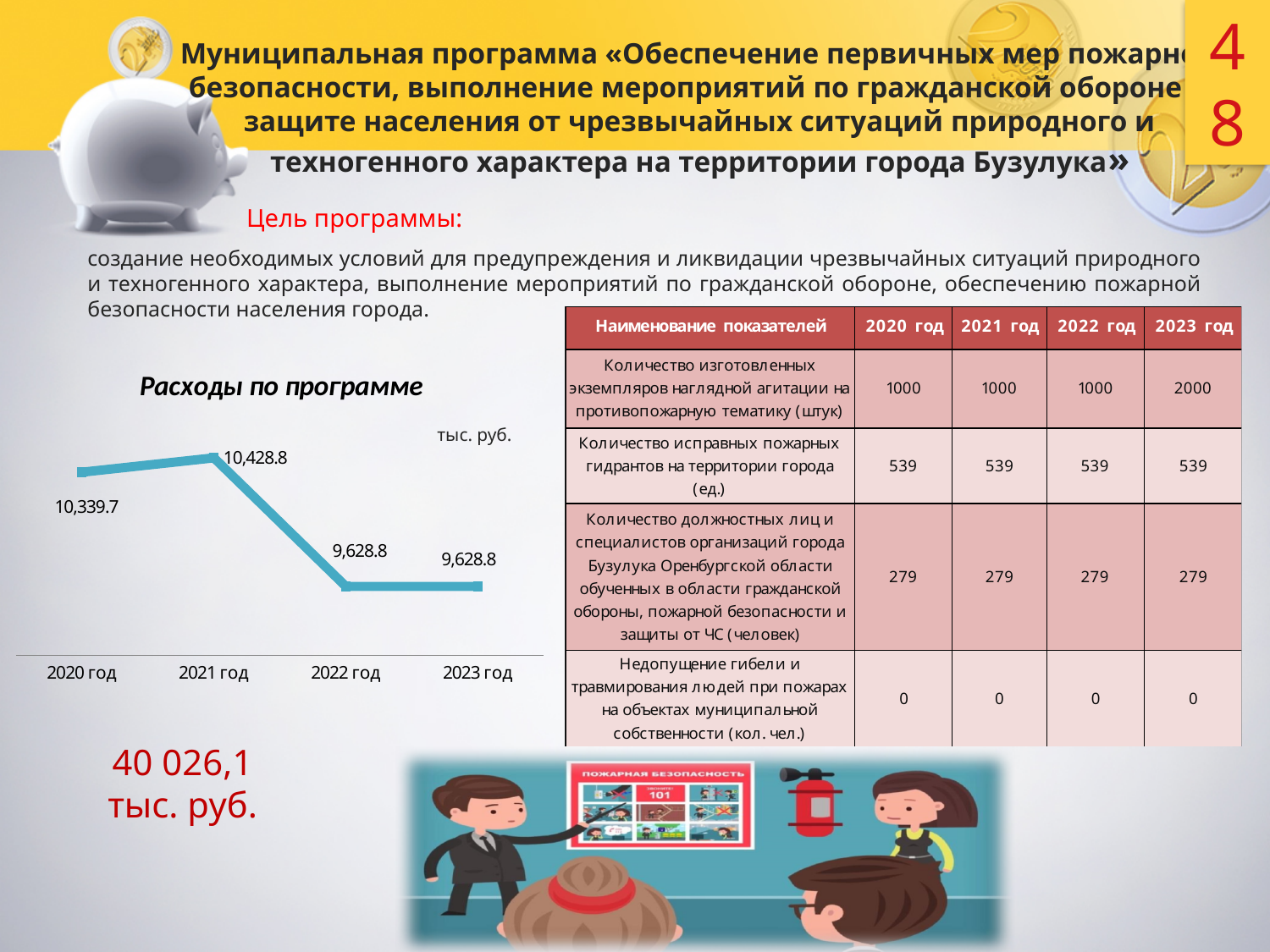
In the chart «Расходы по программе», which is larger: the value for 2020 год or the value for 2022 год? 2020 год What is the value for 2021 год in the chart «Расходы по программе»? 10,428.8 What is the difference between the values for 2021 год and 2020 год in the chart «Расходы по программе»? 89.1 What is the value for 2020 год in the chart «Расходы по программе»? 10,339.7 How many years are plotted in the chart «Расходы по программе»? 4 What is the value for 2022 год in the chart «Расходы по программе»? 9,628.8 What type of chart is «Расходы по программе»? line chart What is the value for 2023 год in the chart «Расходы по программе»? 9,628.8 What unit is shown for the values in the chart «Расходы по программе»? тыс. руб. Which year has the highest value in the chart «Расходы по программе»? 2021 год What is the difference between the values for 2021 год and 2022 год in the chart «Расходы по программе»? 800 In the chart «Расходы по программе», do the values rise or fall from 2021 год to 2022 год? fall